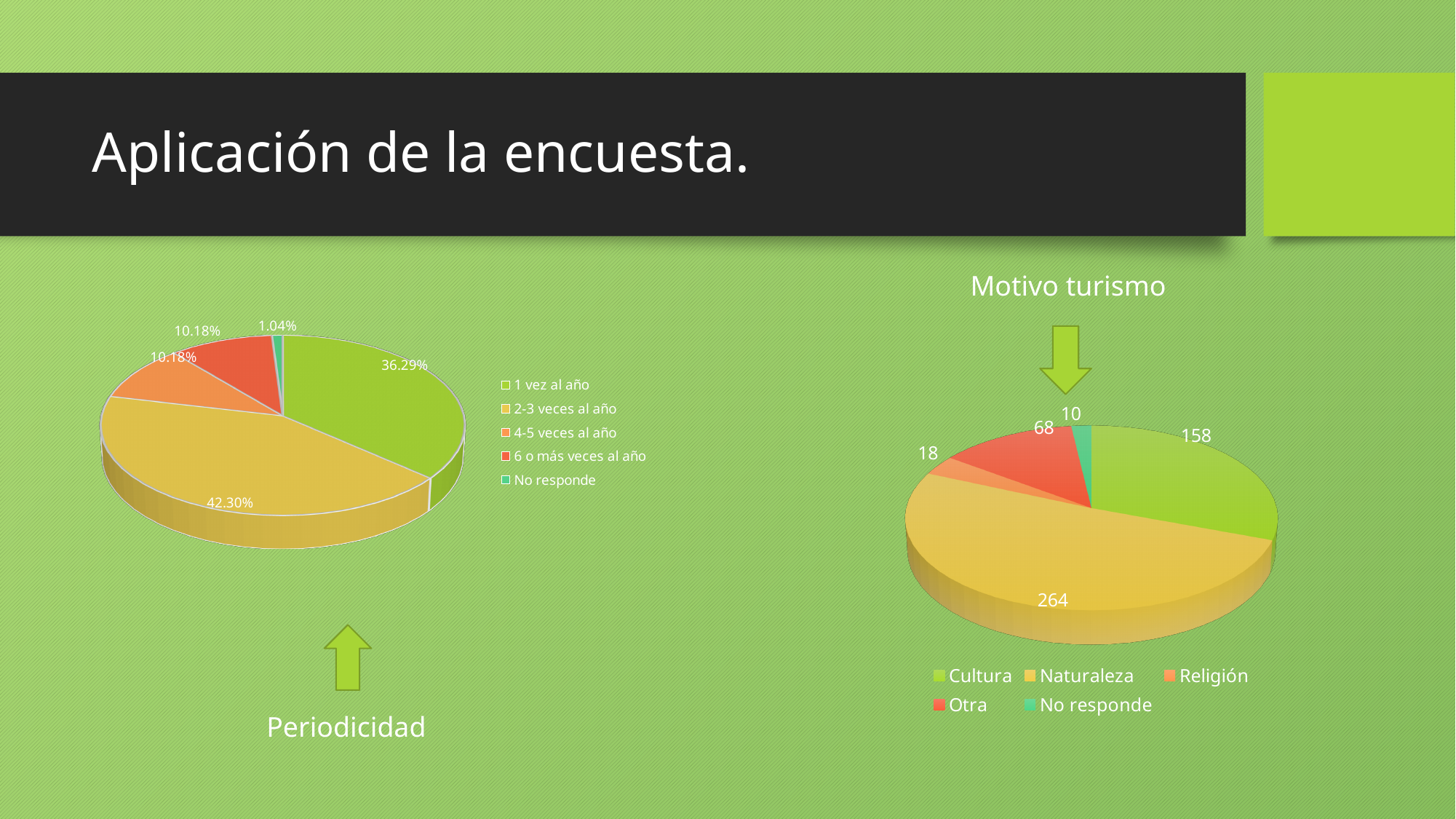
In the Motivo turismo chart, what is the difference between Naturaleza and Cultura? 106 In the Periodicidad chart, which category has the smallest share? No responde In the Motivo turismo chart, which is larger, Otra or Religión? Otra In the Periodicidad chart, what percentage is shown for 2-3 veces al año? 42.30% In the Periodicidad chart, how many categories does the legend list? 5 In the Motivo turismo chart, what is the value for Naturaleza? 264 In the Periodicidad chart, what percentage is shown for 1 vez al año? 36.29% In the Periodicidad chart, which category has the largest share? 2-3 veces al año What type of chart is the Motivo turismo chart? Pie chart In the Periodicidad chart, what percentage is shown for No responde? 1.04% In the Motivo turismo chart, what is the value for Religión? 18 In the Motivo turismo chart, which category has the highest value? Naturaleza